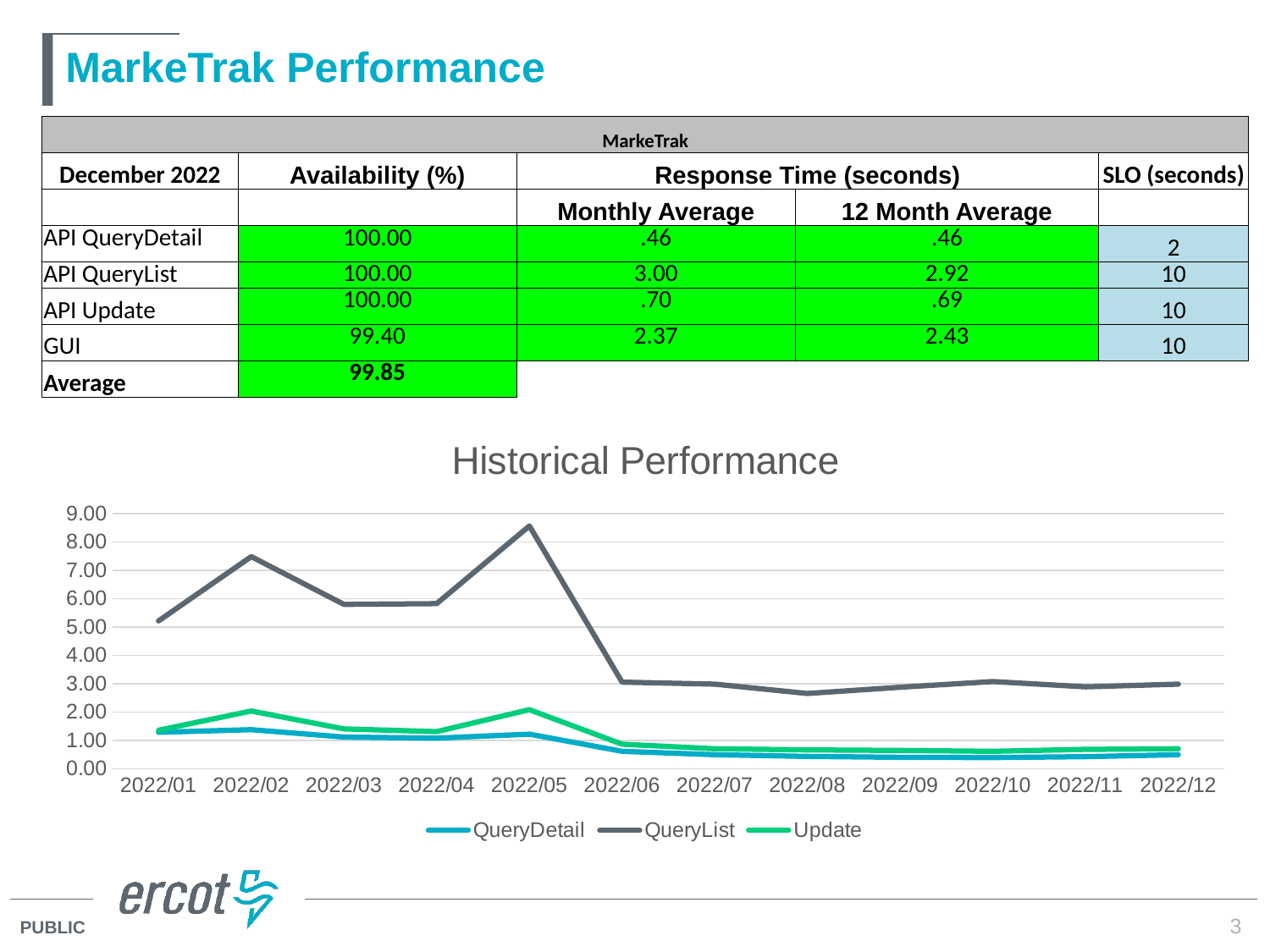
In the Historical Performance chart, which is larger at 2022/05: QueryList or Update? QueryList How many series does the legend of the Historical Performance chart list? 3 In the Historical Performance chart, in which month does the QueryList series reach its peak? 2022/05 In the Historical Performance chart, which series has the highest values across the months? QueryList In the Historical Performance chart, is the QueryDetail value for 2022/12 greater or less than 1.00? less What kind of chart is the Historical Performance chart? line chart In the Historical Performance chart, is the QueryList value for 2022/05 greater or less than 8.00? greater How many months are shown on the x axis of the Historical Performance chart? 12 In the Historical Performance chart, is the Update value for 2022/02 greater or less than 1.00? greater What is the title of the line chart on the slide? Historical Performance In the Historical Performance chart, does the QueryList series rise or fall between 2022/05 and 2022/06? fall